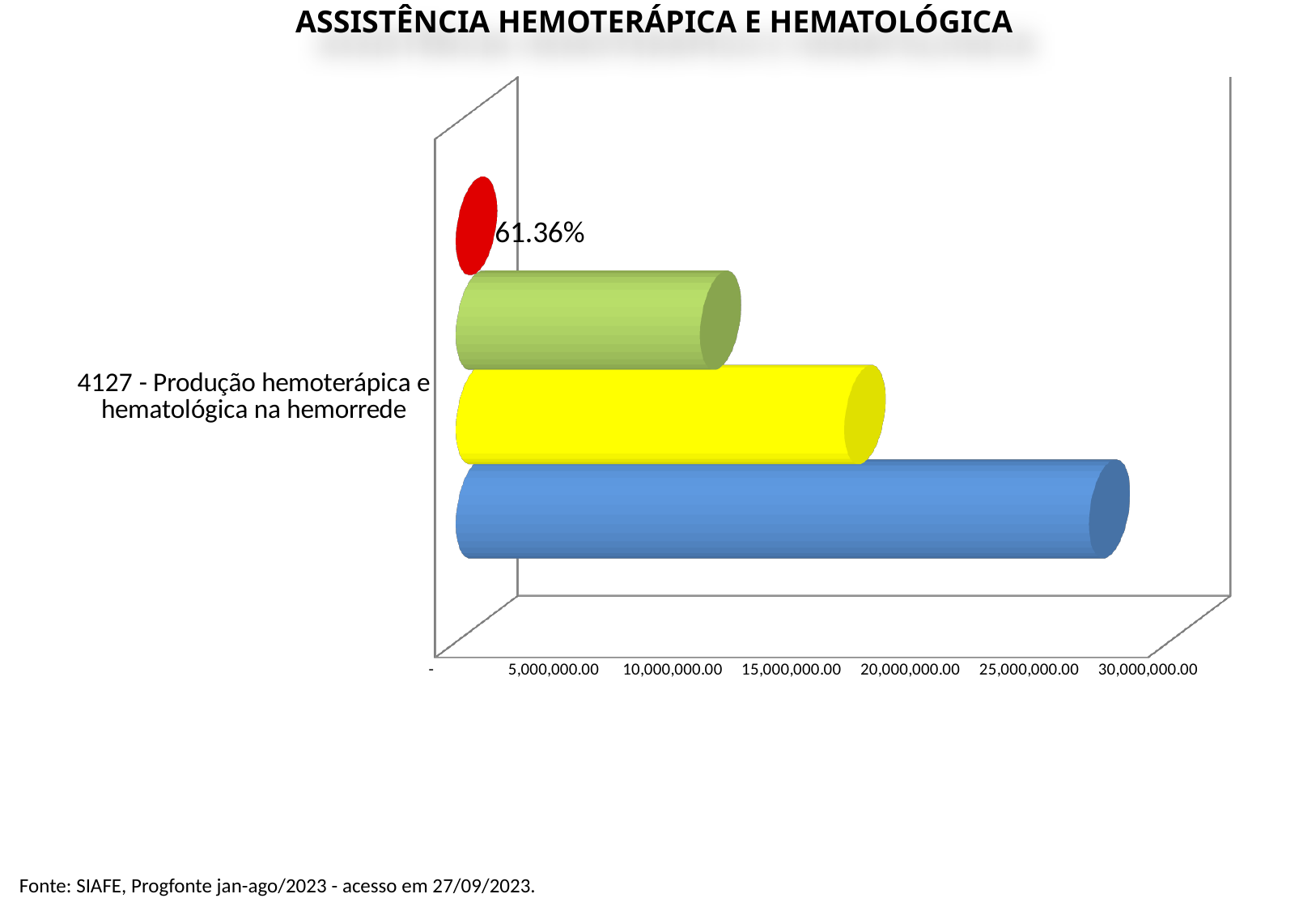
What is the title of the chart? ASSISTÊNCIA HEMOTERÁPICA E HEMATOLÓGICA What kind of chart is shown on the slide? bar chart Is the value of the green bar greater or less than 15,000,000.00? less How many categories are shown on the vertical axis of the chart? 1 Which is larger, the value of the blue bar or the value of the green bar? blue bar Is the value of the blue bar greater or less than 25,000,000.00? greater Is the value of the yellow bar greater or less than 20,000,000.00? less Which coloured bar is the shortest in the chart? red Which coloured bar is the longest in the chart? blue What is the category label shown on the vertical axis? 4127 - Produção hemoterápica e hematológica na hemorrede What percentage value is printed as a data label next to the red marker? 61.36%